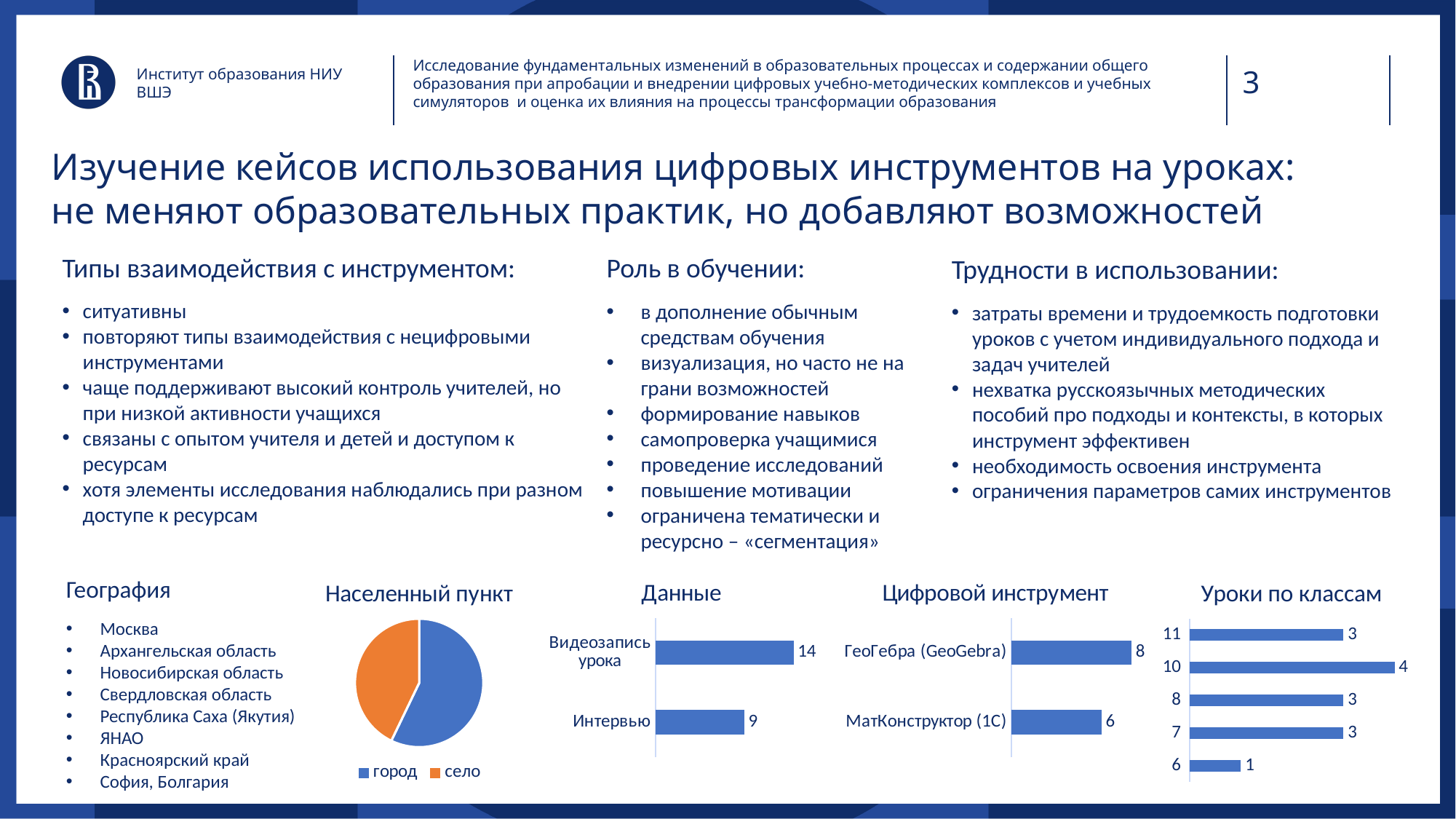
In the 'Уроки по классам' chart, what is the value for class 6? 1 How many categories are shown in the 'Уроки по классам' chart? 5 In the 'Данные' chart, what is the value for 'Видеозапись урока'? 14 In the 'Цифровой инструмент' chart, which category has the lower value? МатКонструктор (1С) In the 'Уроки по классам' chart, what is the total of all values? 14 In the 'Цифровой инструмент' chart, what is the difference between 'ГеоГебра (GeoGebra)' and 'МатКонструктор (1С)'? 2 What kind of chart is 'Населенный пункт'? Pie chart In the 'Населенный пункт' pie chart, which slice is larger, 'город' or 'село'? город In the 'Данные' chart, what is the difference between 'Видеозапись урока' and 'Интервью'? 5 In the 'Уроки по классам' chart, which class has the highest value? 10 In the 'Цифровой инструмент' chart, what is the value for 'ГеоГебра (GeoGebra)'? 8 In the 'Данные' chart, what is the value for 'Интервью'? 9